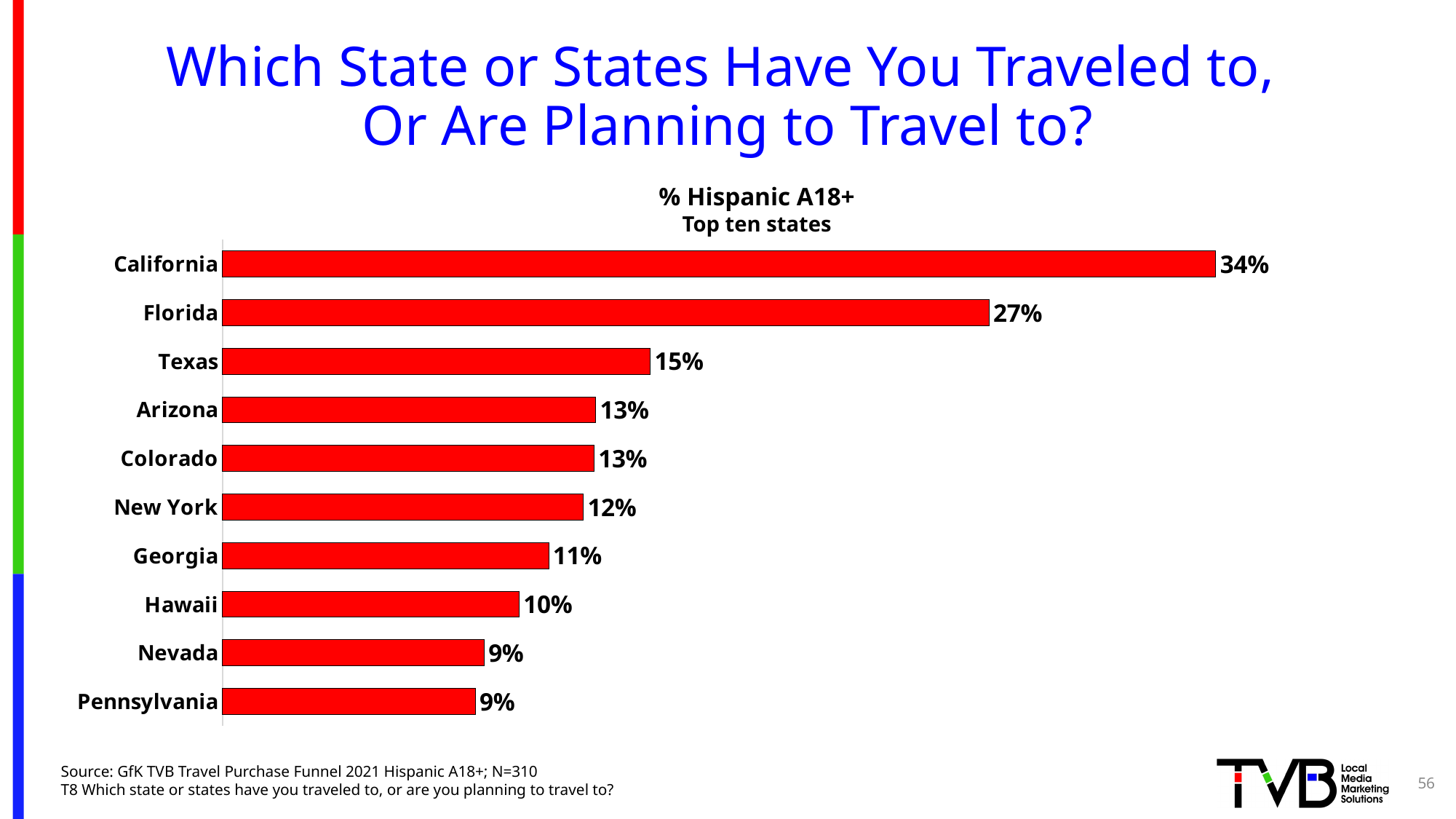
Which two states share the lowest value of 9%? Nevada and Pennsylvania What is the value shown for Hawaii? 10% How many states are shown on the chart? 10 Which state has the highest percentage on the chart? California What kind of chart is shown on the slide? Bar chart Which has a higher value, Georgia or Nevada? Georgia What is the difference in percentage points between Texas and New York? 3 What is the value shown for Florida? 27% What is the difference in percentage points between California and Florida? 7 What is the subtitle printed above the chart? % Hispanic A18+ Top ten states What percentage of Hispanic adults 18+ have traveled to or are planning to travel to California? 34% Which has a higher value, Florida or Texas? Florida